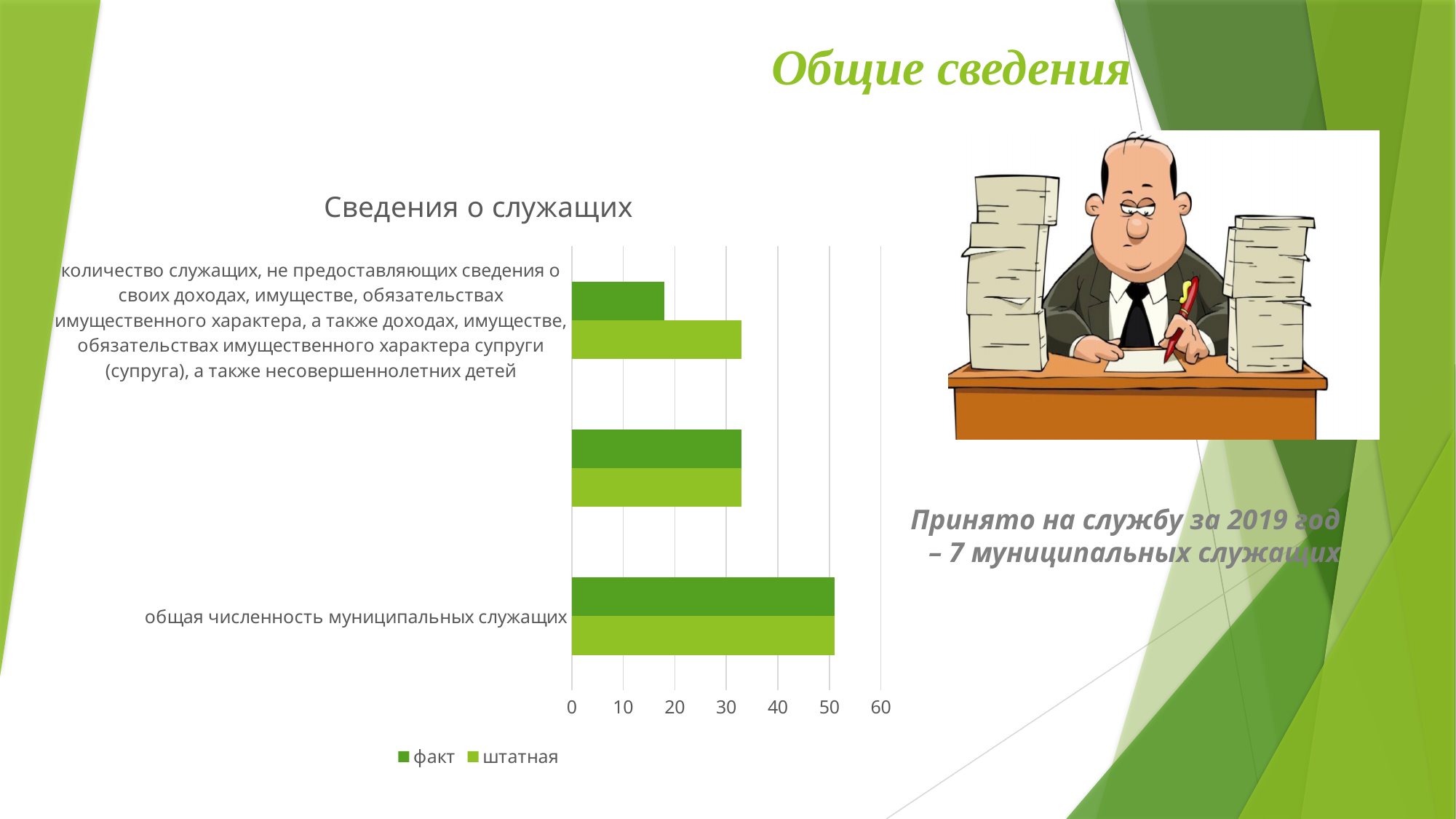
Is the факт value for 'количество служащих, не предоставляющих сведения...' greater or less than 20? less What is the title of the chart? Сведения о служащих What kind of chart is shown on the slide? bar chart How many categories are plotted in the chart? 3 How many series does the chart legend list? 2 Is the факт value for 'общая численность муниципальных служащих' greater or less than 40? greater For the category 'количество служащих, не предоставляющих сведения...', which series has the larger value, факт or штатная? штатная Is the штатная value for 'количество служащих, не предоставляющих сведения...' greater or less than 30? greater What are the two series named in the chart legend? факт and штатная Which category has the highest факт value? общая численность муниципальных служащих